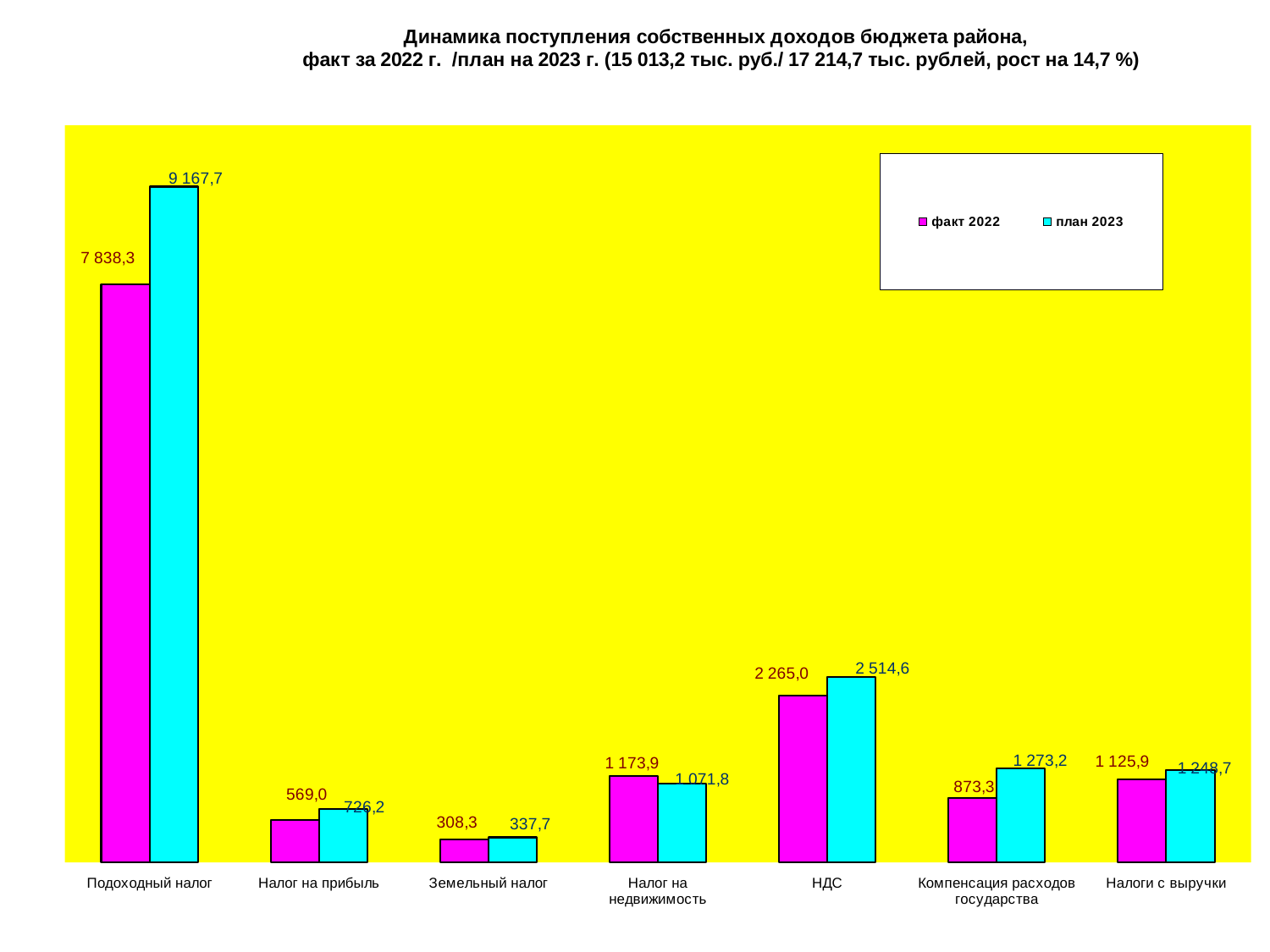
What is the difference between the план 2023 and факт 2022 values for Компенсация расходов государства? 399,9 What is the факт 2022 value for Земельный налог? 308,3 How many series does the legend list? 2 Which category has the lowest факт 2022 value? Земельный налог What is the план 2023 value for Компенсация расходов государства? 1 273,2 How many categories are shown on the x axis? 7 Which category has the highest план 2023 value? Подоходный налог What is the факт 2022 value for Подоходный налог? 7 838,3 What kind of chart is shown on the slide? bar chart What is the difference between the план 2023 and факт 2022 values for Подоходный налог? 1 329,4 For Налог на недвижимость, which is larger: факт 2022 or план 2023? факт 2022 What is the план 2023 value for НДС? 2 514,6